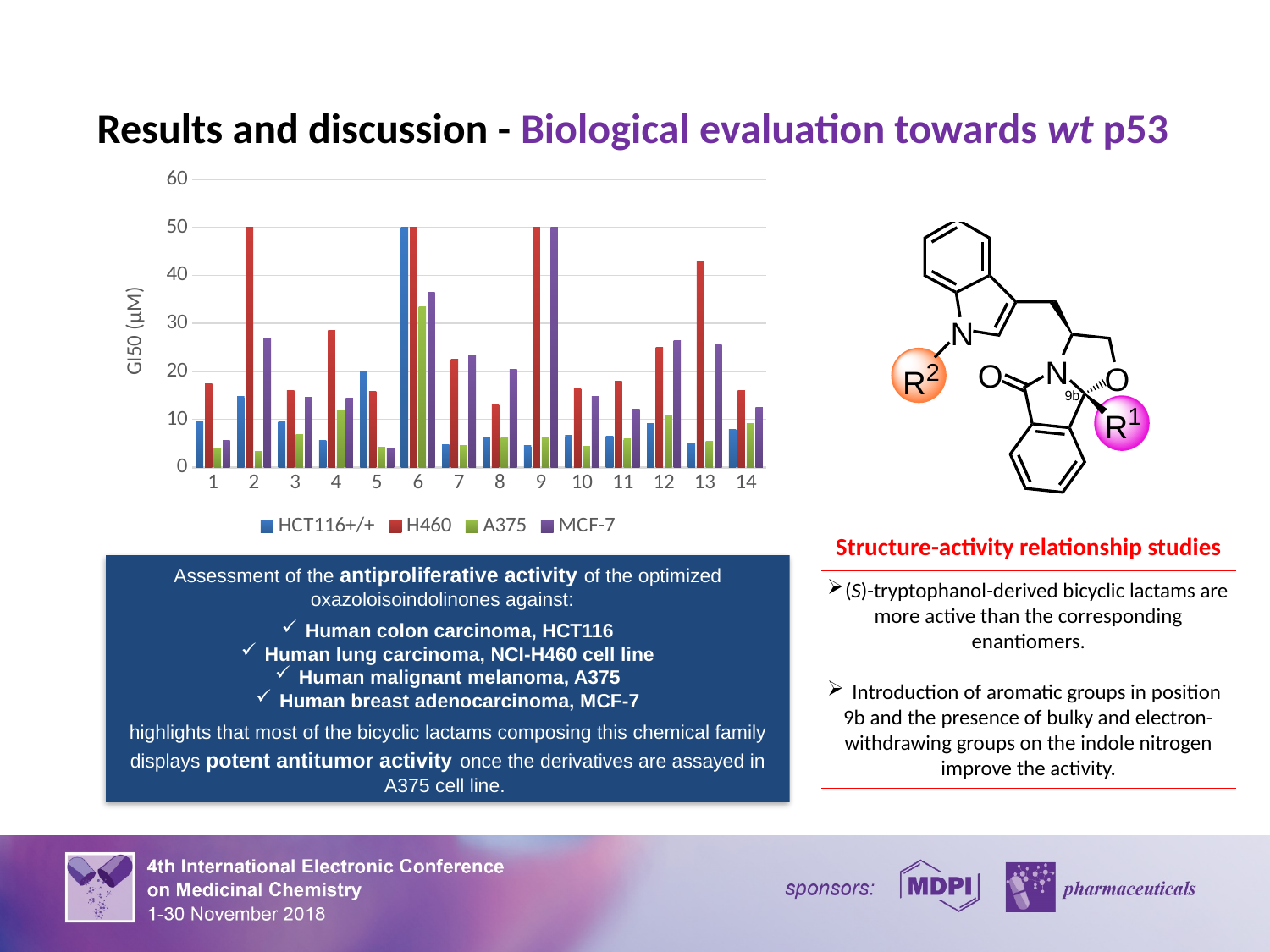
Is the MCF-7 value for compound 2 greater or less than 20? greater What kind of chart is shown on the slide? bar chart How many compound categories are shown along the x axis of the chart? 14 For which compound is the A375 value the highest? 6 What is the label of the vertical axis of the chart? GI50 (µM) How many series does the chart legend list? 4 Is the H460 value for compound 13 greater or less than 40? greater Is the HCT116+/+ value for compound 5 greater or less than 10? greater For compound 6, which is larger: the A375 value or the MCF-7 value? MCF-7 For which compound is the MCF-7 value the highest? 9 Which colour represents the H460 series in the chart legend? red For compound 13, which is larger: the H460 value or the MCF-7 value? H460